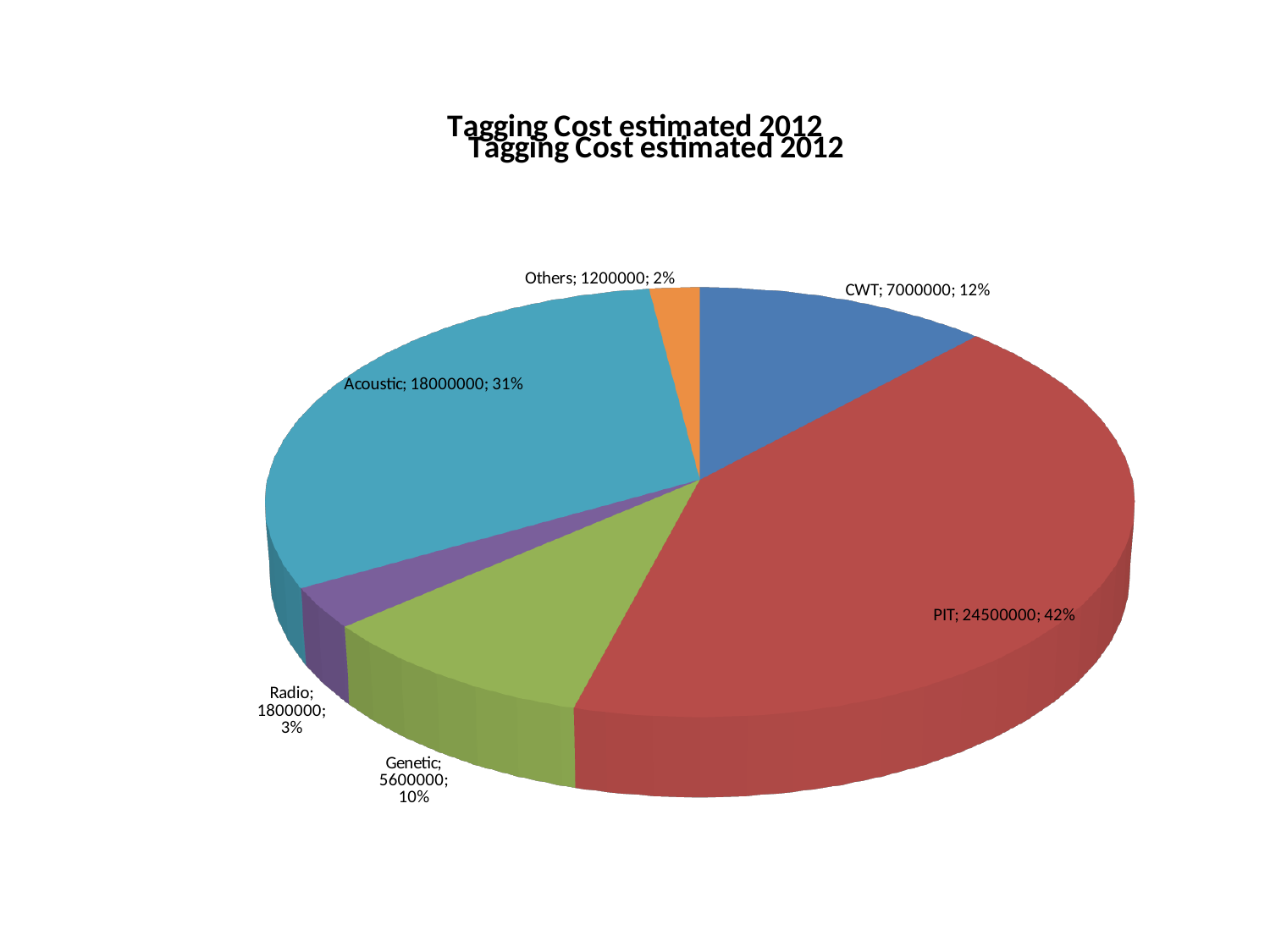
What is the estimated tagging cost for Acoustic? 18000000 Which category has the highest estimated tagging cost? PIT What share of the pie does Radio represent? 3% What kind of chart is shown on the slide? Pie chart Which has a larger estimated tagging cost, CWT or Genetic? CWT What is the difference between the estimated tagging cost for PIT and for Acoustic? 6500000 What share of the pie does Acoustic represent? 31% What is the estimated tagging cost for PIT? 24500000 What is the estimated tagging cost for Genetic? 5600000 Which category has the lowest estimated tagging cost? Others How many categories are shown in the pie chart? 6 What is the estimated tagging cost for CWT? 7000000